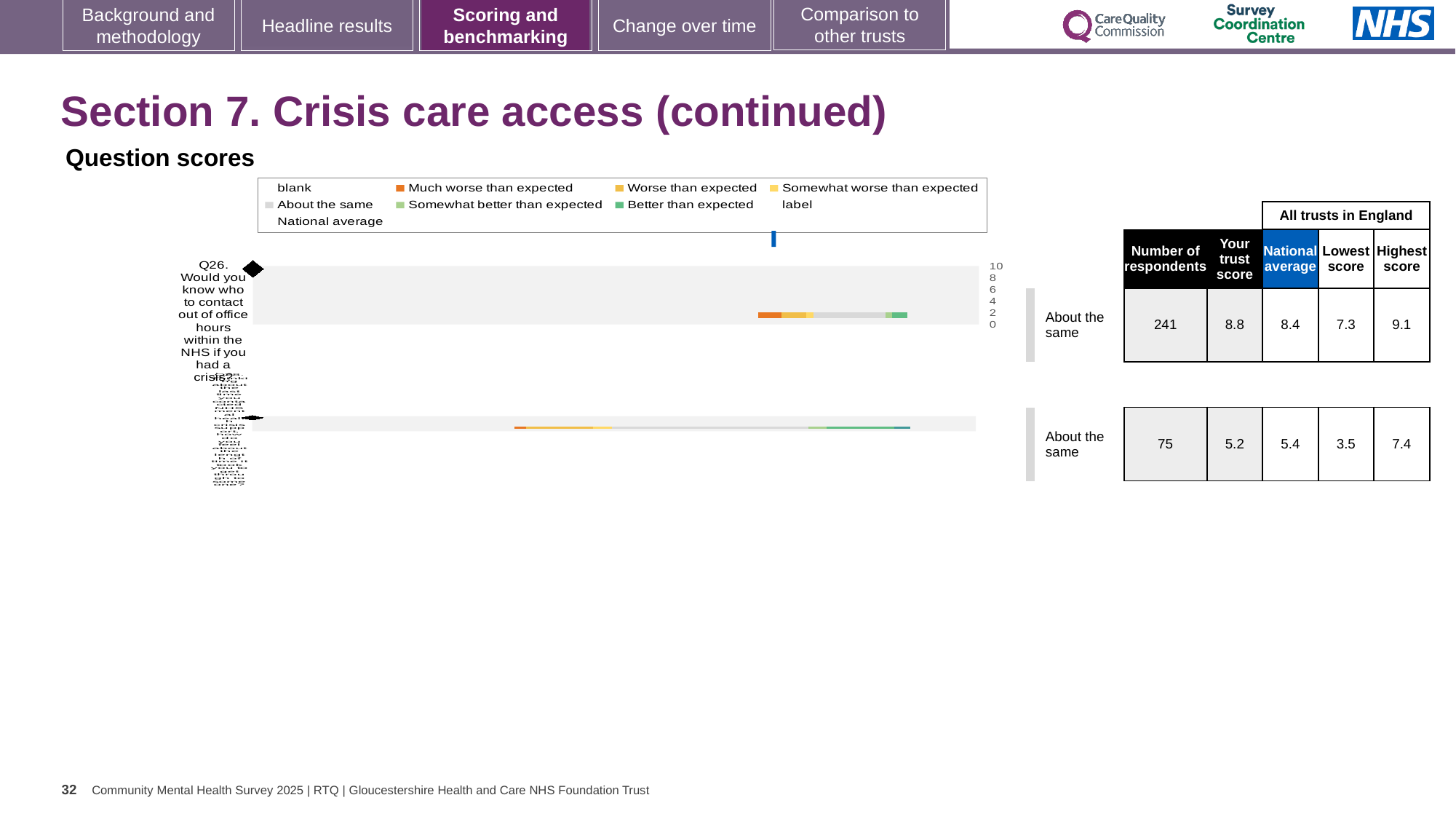
What colour represents 'Much worse than expected' in the legend? orange How many question bars are plotted in the chart? 2 How many respondents answered Q26? 241 For Q26, which is larger: the trust score or the national average? the trust score What is the highest score among all trusts in England for Q26? 9.1 What is the trust score for Q26 (Would you know who to contact out of office hours within the NHS if you had a crisis?)? 8.8 For Q26, how much higher is the trust score than the national average? 0.4 What is the national average for Q26? 8.4 What benchmark category is shown for Q26? About the same What is the lowest score among all trusts in England for Q26? 7.3 What kind of chart is shown under 'Question scores'? bar chart For Q26, what is the difference between the highest score and the lowest score among all trusts in England? 1.8